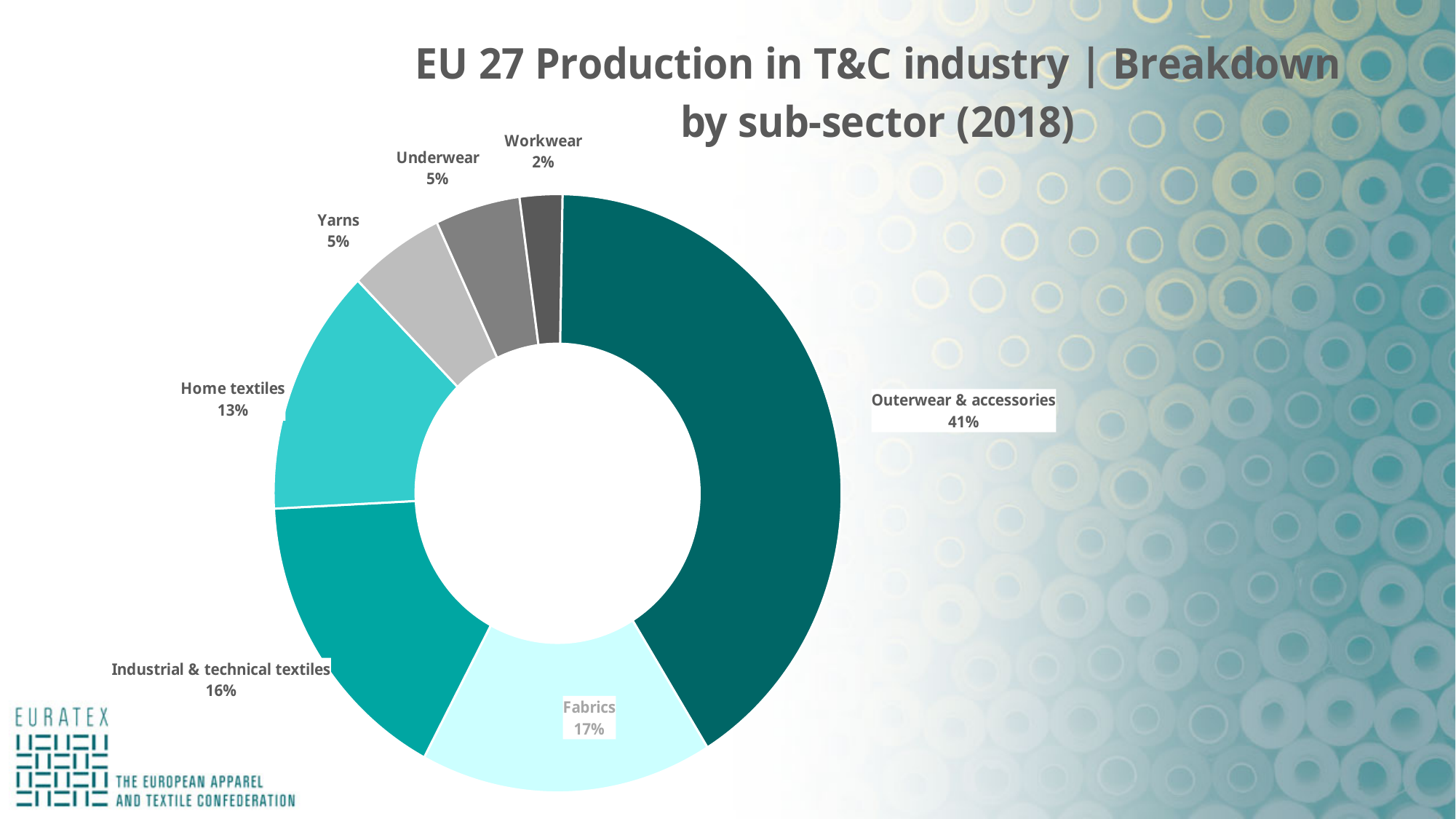
Which sub-sector has the largest share of production? Outerwear & accessories What is the difference in percentage points between Outerwear & accessories and Fabrics? 24 percentage points What share of EU 27 T&C production does Outerwear & accessories account for? 41% What is the share for Industrial & technical textiles? 16% Which sub-sector has the smallest share of production? Workwear How many sub-sectors are shown in the chart? 7 What year does the chart title say the data is for? 2018 Which two sub-sectors each have a 5% share? Yarns and Underwear What percentage is shown for Home textiles? 13% Which has a larger share, Fabrics or Industrial & technical textiles? Fabrics What kind of chart is shown on the slide? Pie chart (doughnut) What is the share for Workwear? 2%